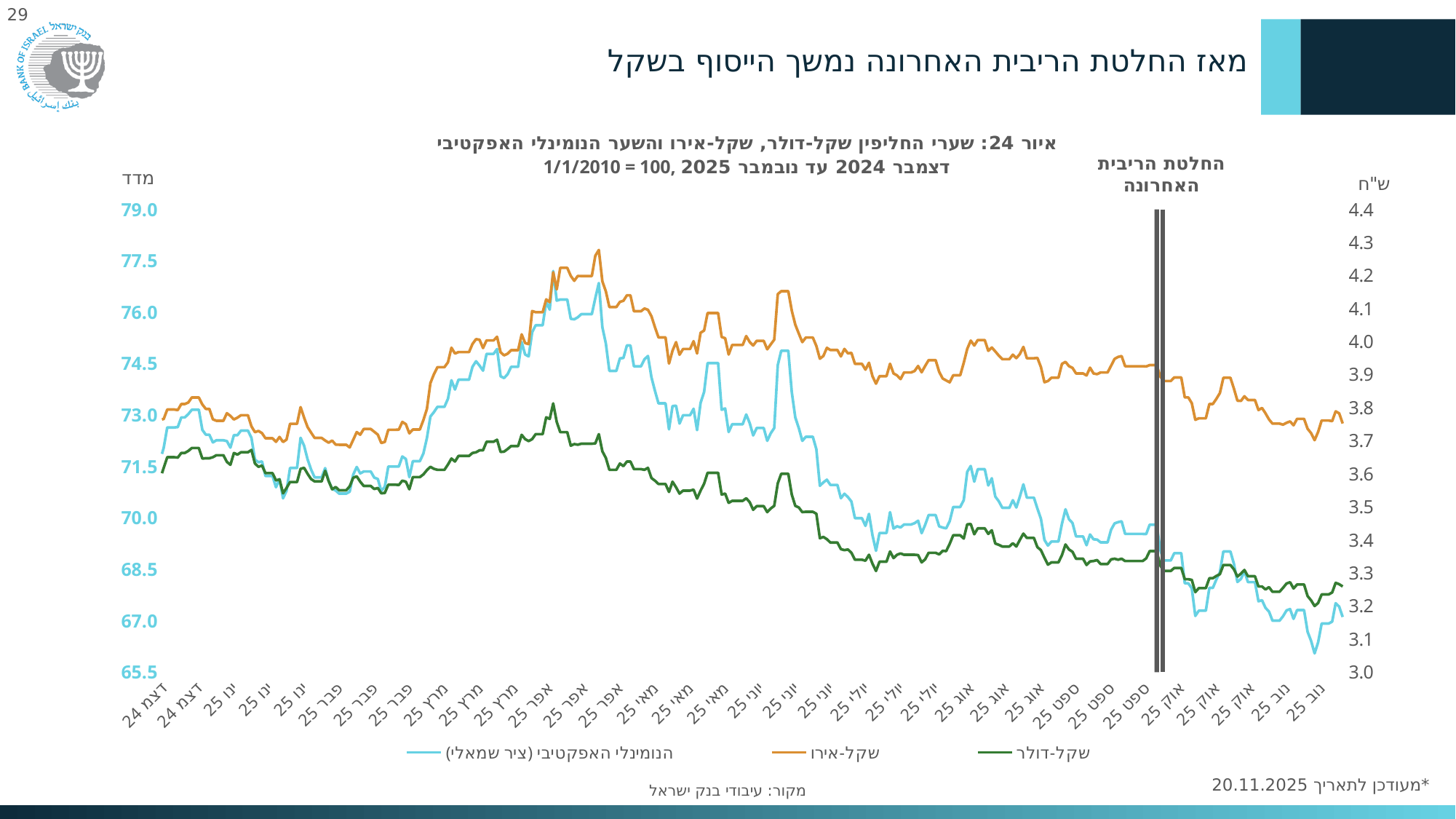
Is the highest value of the הנומינלי האפקטיבי series greater or less than 76.0? greater How many series does the chart legend list? 3 Which series is plotted on the left axis according to the legend? הנומינלי האפקטיבי (ציר שמאלי) Is the value of the הנומינלי האפקטיבי series at the end of נוב 25 greater or less than 68.5? less Is the highest value of the שקל-אירו series greater or less than 4.2? greater In נוב 25, which series has the higher value on the right axis, שקל-אירו or שקל-דולר? שקל-אירו Does the שקל-דולר series rise or fall from דצמ 24 to נוב 25? fall What does the vertical double line near אוק 25 mark? החלטת הריבית האחרונה What kind of chart is shown on the slide? line chart What is the highest tick value shown on the right-hand (ש"ח) axis? 4.4